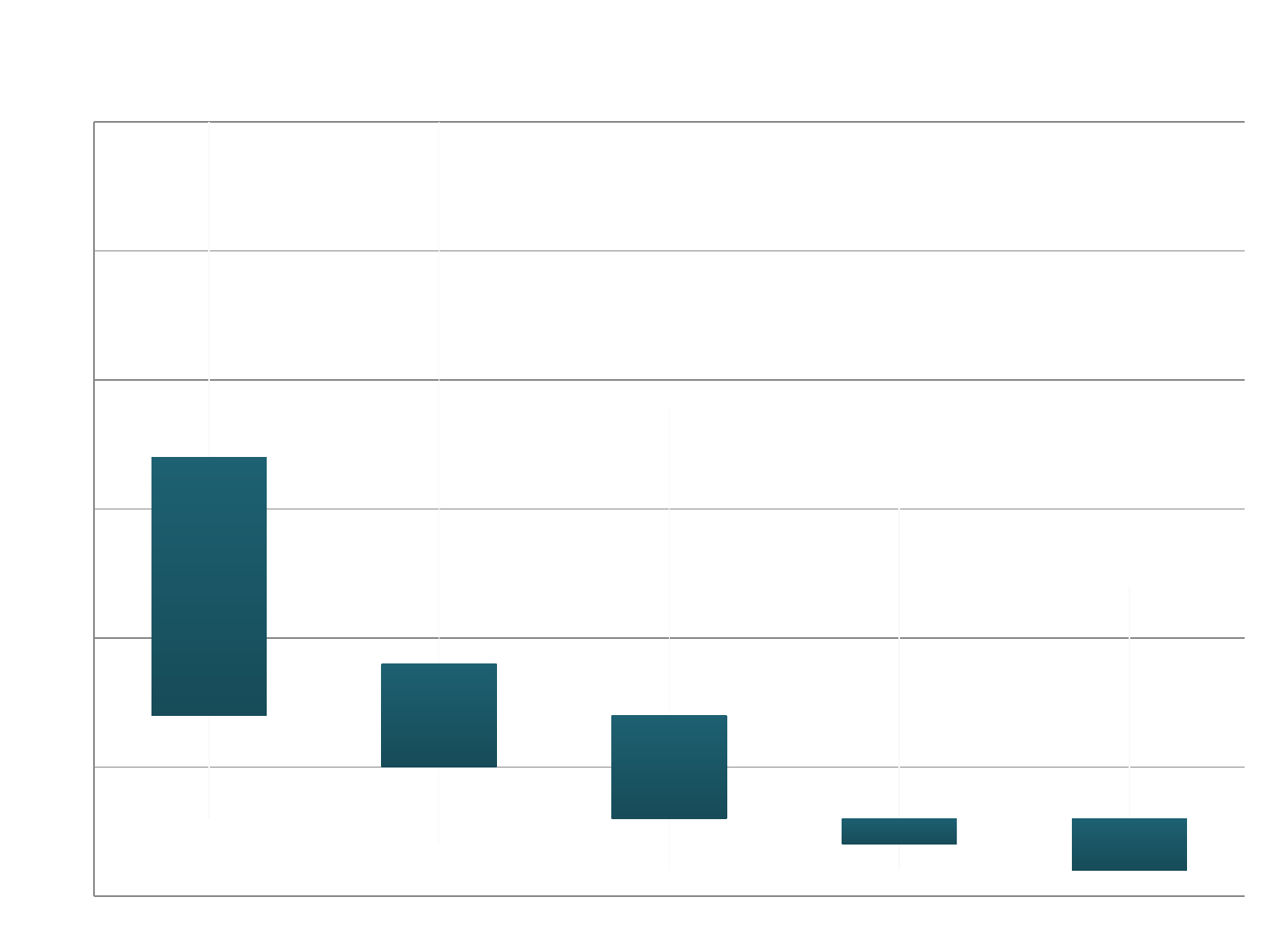
What kind of chart is shown on the slide? bar chart What colour are the bars in the chart? dark teal How many bars are plotted in the chart? 5 Which bar is the tallest: the first (leftmost) bar or the last (rightmost) bar? the first (leftmost) bar Do the tops of the bars rise or fall from left to right across the chart? fall